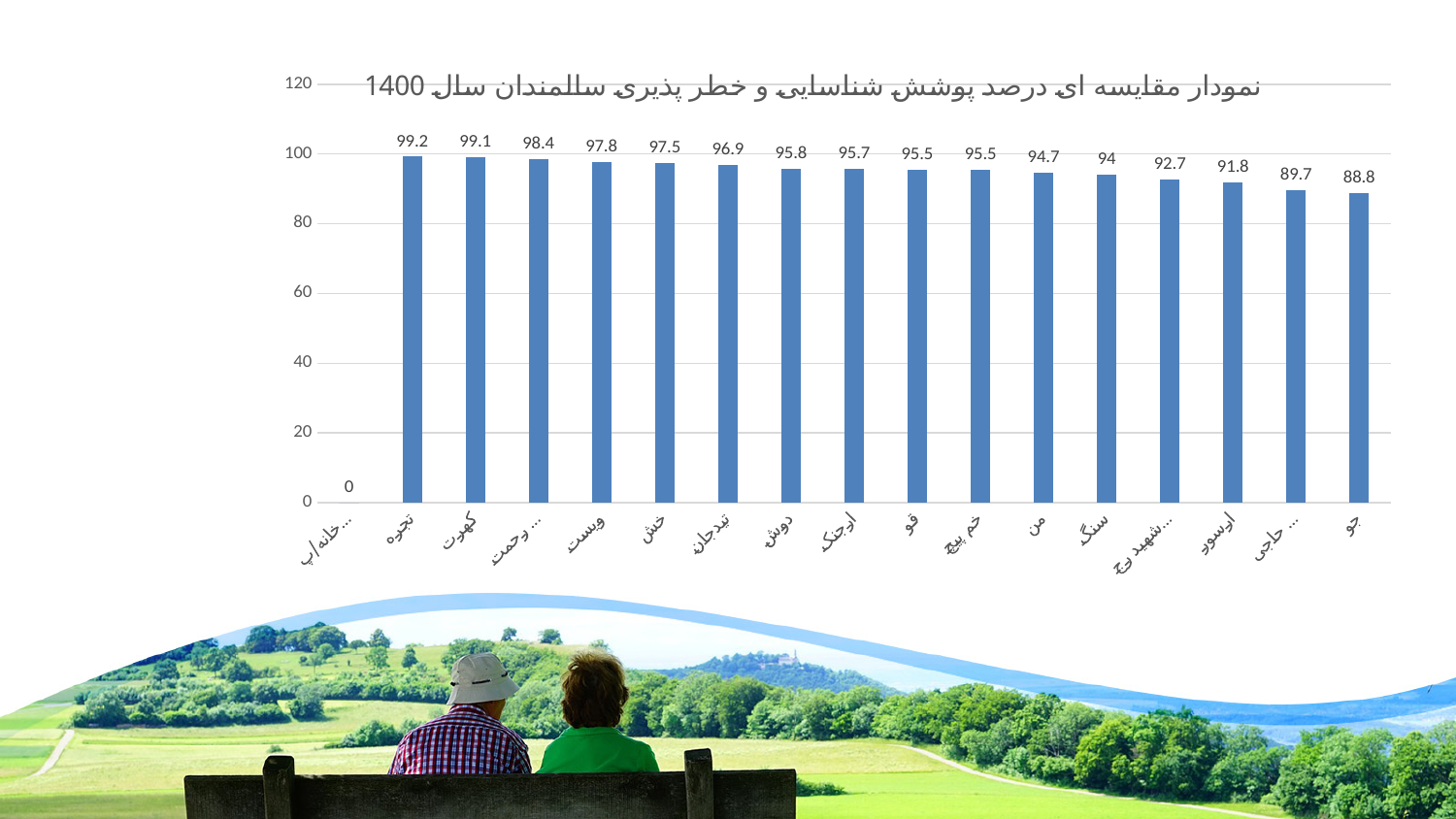
What kind of chart is shown on the slide? bar chart What is the value of the bar labelled من? 94.7 Ignoring the first bar at 0, do the bar values rise or fall from left to right? fall What is the value of the rightmost bar, labelled جو? 88.8 Is the value for the rightmost bar (جو) greater or less than 80? greater How many bars (categories) are plotted in the chart? 17 What is the value of the tallest bar in the chart? 99.2 Which is larger: the value of the bar labelled سنگ or the bar labelled جو? سنگ What is the difference between the highest bar value (99.2) and the value of the rightmost bar (88.8)? 10.4 What is the value of the leftmost bar in the chart? 0 What is the value of the bar labelled سنگ? 94 What is the value of the second bar from the left? 99.2